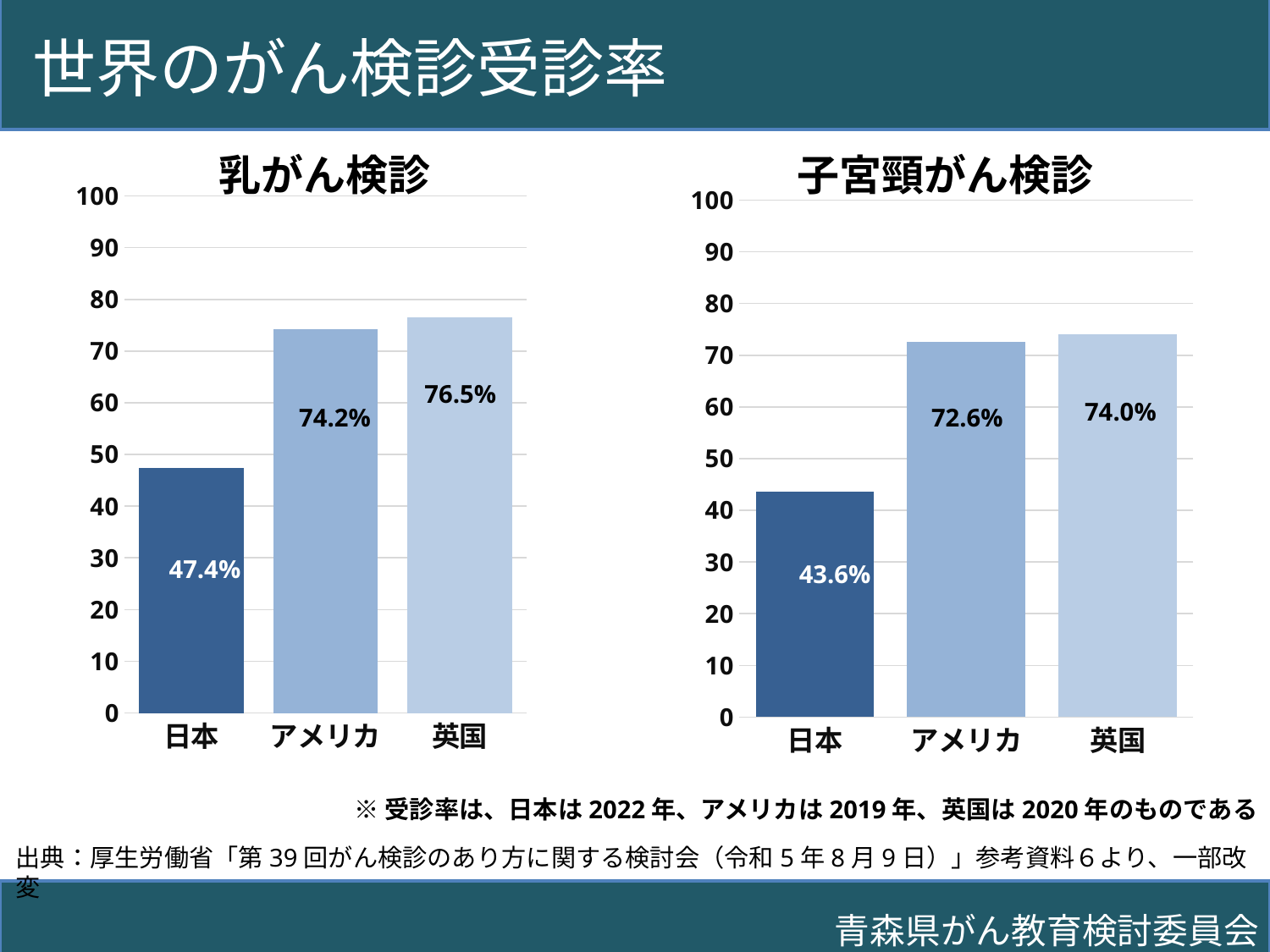
What kind of chart is the 乳がん検診 chart? bar chart In the 子宮頸がん検診 chart, which is larger, the value for 日本 or the value for アメリカ? アメリカ In the 子宮頸がん検診 chart, what is the difference between the values for 英国 and アメリカ? 1.4% In the 乳がん検診 chart, is the value for 日本 greater or less than 50? less In the 子宮頸がん検診 chart, what is the value for 英国? 74.0% In the 子宮頸がん検診 chart, what is the value for アメリカ? 72.6% What is the title of the chart on the left side of the slide? 乳がん検診 In the 乳がん検診 chart, which country has the highest value? 英国 In the 乳がん検診 chart, what is the value for 日本? 47.4% How many countries are shown in the 子宮頸がん検診 chart? 3 In the 子宮頸がん検診 chart, which country has the lowest value? 日本 In the 乳がん検診 chart, what is the difference between the values for 英国 and 日本? 29.1%